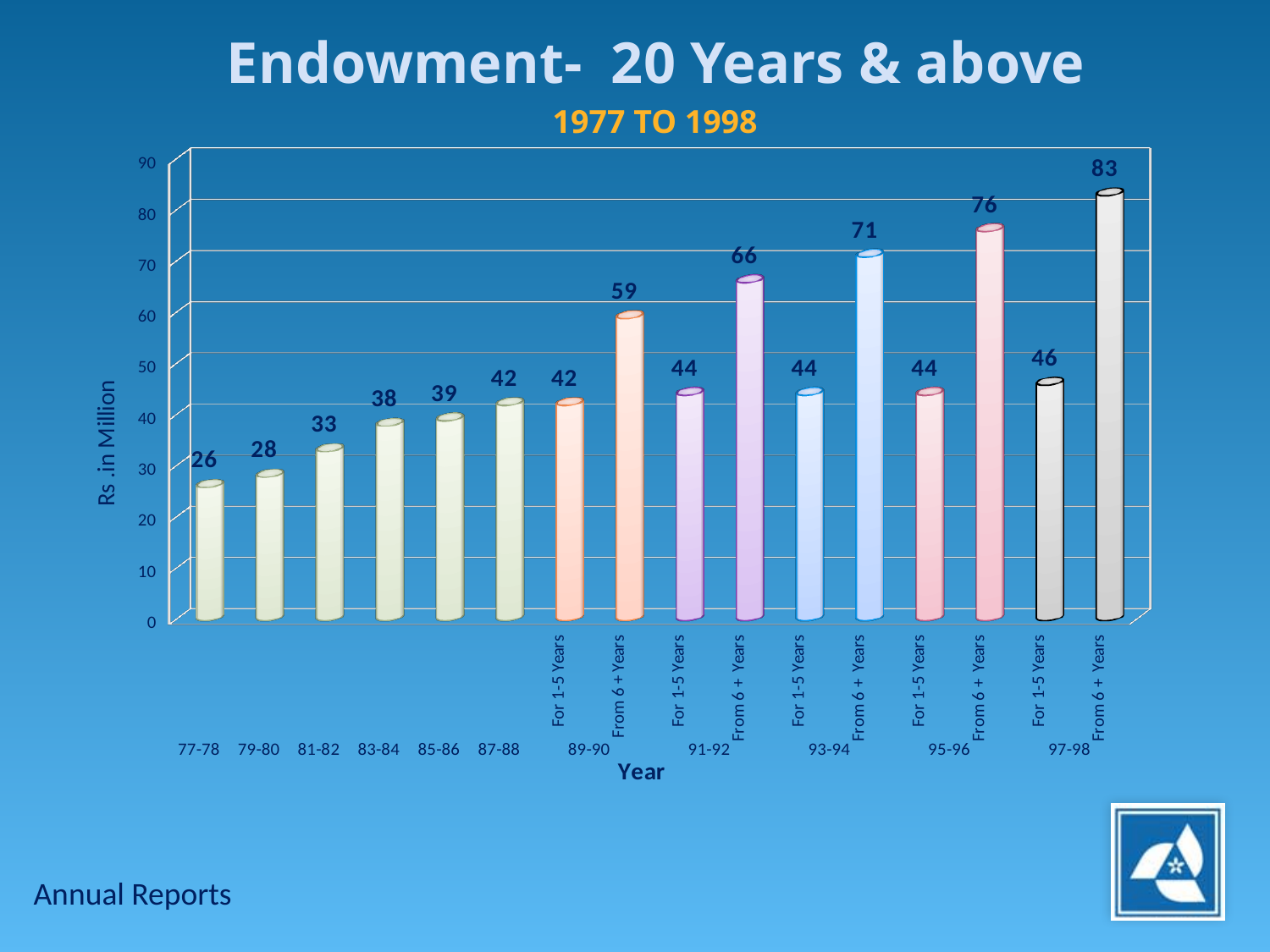
How many bars are plotted in the chart? 16 What is the difference between the 'From 6 + Years' and 'For 1-5 Years' values in 95-96? 32 What is the label of the vertical axis? Rs .in Million What is the value for 77-78? 26 Do the 'From 6 + Years' values rise or fall from 89-90 to 97-98? Rise What is the value for 'From 6 + Years' in 89-90? 59 Which is larger, the value for 83-84 or the value for 85-86? 85-86 Is the value for 'From 6 + Years' in 93-94 greater or less than 70? greater Which bar has the highest value? 97-98 From 6 + Years (83) Which bar has the lowest value? 77-78 (26) What type of chart is shown on the slide? Bar chart What is the value for 'For 1-5 Years' in 97-98? 46